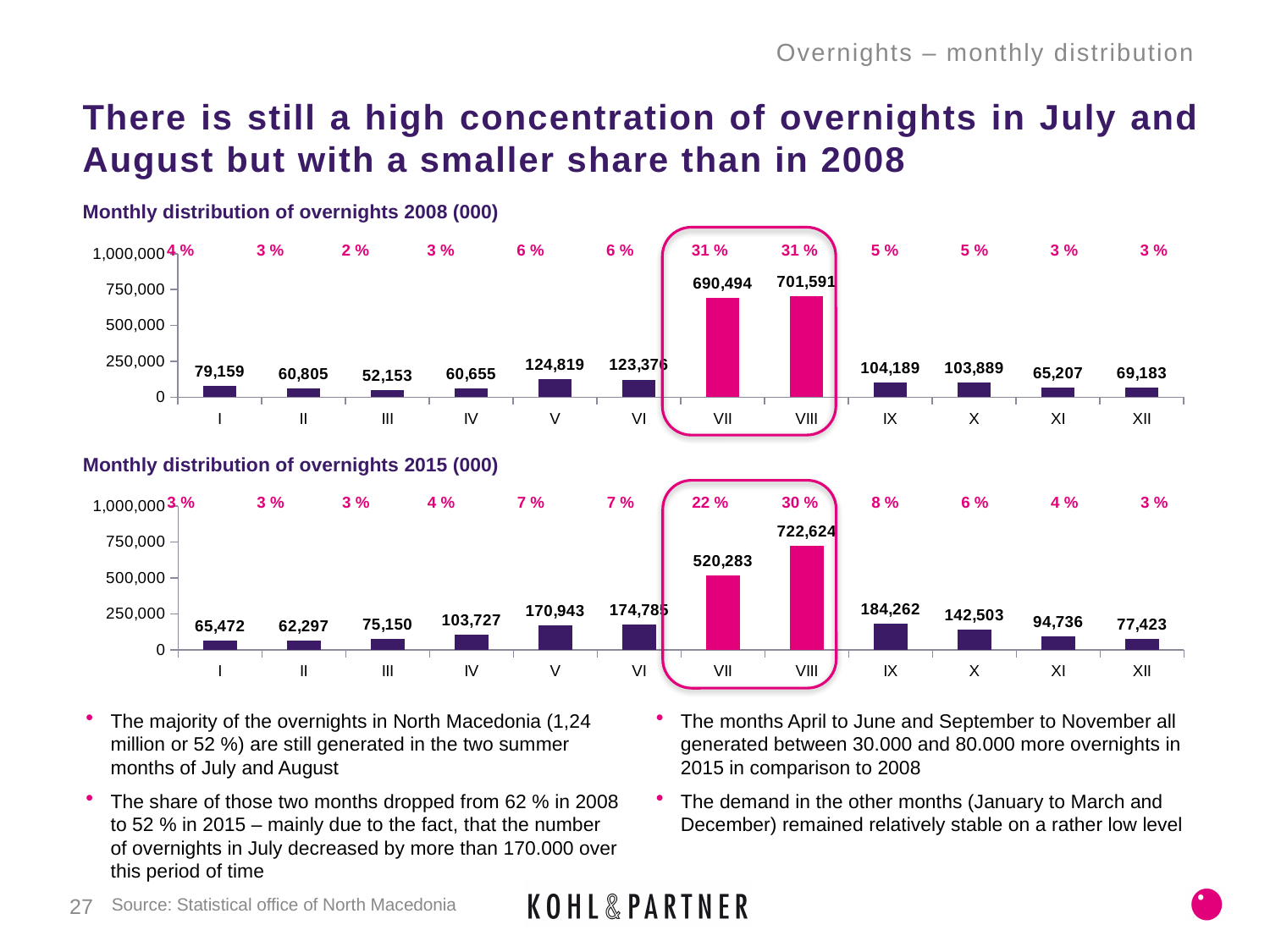
In the 'Monthly distribution of overnights 2008 (000)' chart, what percentage share is shown above month VII? 31 % In the 'Monthly distribution of overnights 2008 (000)' chart, which month has the lowest value? III How many months (categories) are shown on the x axis of the 'Monthly distribution of overnights 2015 (000)' chart? 12 In the 'Monthly distribution of overnights 2015 (000)' chart, what is the value for month VIII? 722,624 In the 'Monthly distribution of overnights 2015 (000)' chart, what is the difference between the values for month VIII and month VII? 202,341 In the 'Monthly distribution of overnights 2015 (000)' chart, which month has the highest value? VIII In the 'Monthly distribution of overnights 2008 (000)' chart, what is the difference between the values for month VIII and month VII? 11,097 In the 'Monthly distribution of overnights 2015 (000)' chart, which month has the lowest value? II In the 'Monthly distribution of overnights 2015 (000)' chart, what is the value for month IX? 184,262 In the 'Monthly distribution of overnights 2008 (000)' chart, what is the value for month VII? 690,494 What type of chart is the 'Monthly distribution of overnights 2008 (000)' chart? Bar chart In the 'Monthly distribution of overnights 2015 (000)' chart, which is larger, the value for month IX or month X? IX